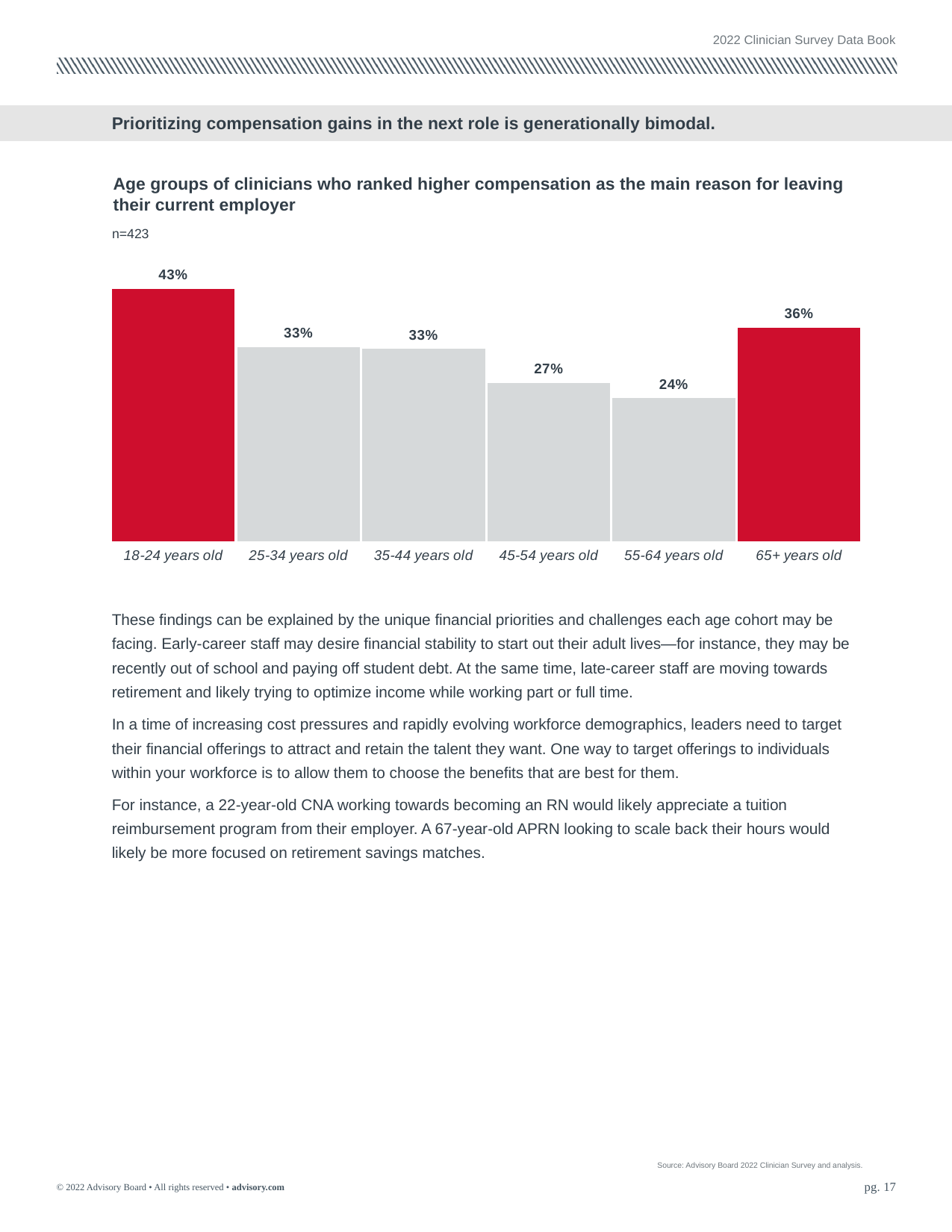
What type of chart is shown on the slide? Bar chart How many age groups are shown in the chart? 6 What is the value shown for the 65+ years old age group? 36% What is the value shown for the 45-54 years old age group? 27% What is the difference in percentage points between the 18-24 years old group and the 65+ years old group? 7 percentage points What is the sample size (n) stated for the chart? n=423 What percentage of clinicians aged 18-24 years old ranked higher compensation as the main reason for leaving their current employer? 43% Which two age groups are highlighted in red in the chart? 18-24 years old and 65+ years old Which age group has the lowest percentage in the chart? 55-64 years old Which age group has the highest percentage in the chart? 18-24 years old Which is larger, the value for 65+ years old or the value for 35-44 years old? 65+ years old What is the difference in percentage points between the 25-34 years old group and the 55-64 years old group? 9 percentage points